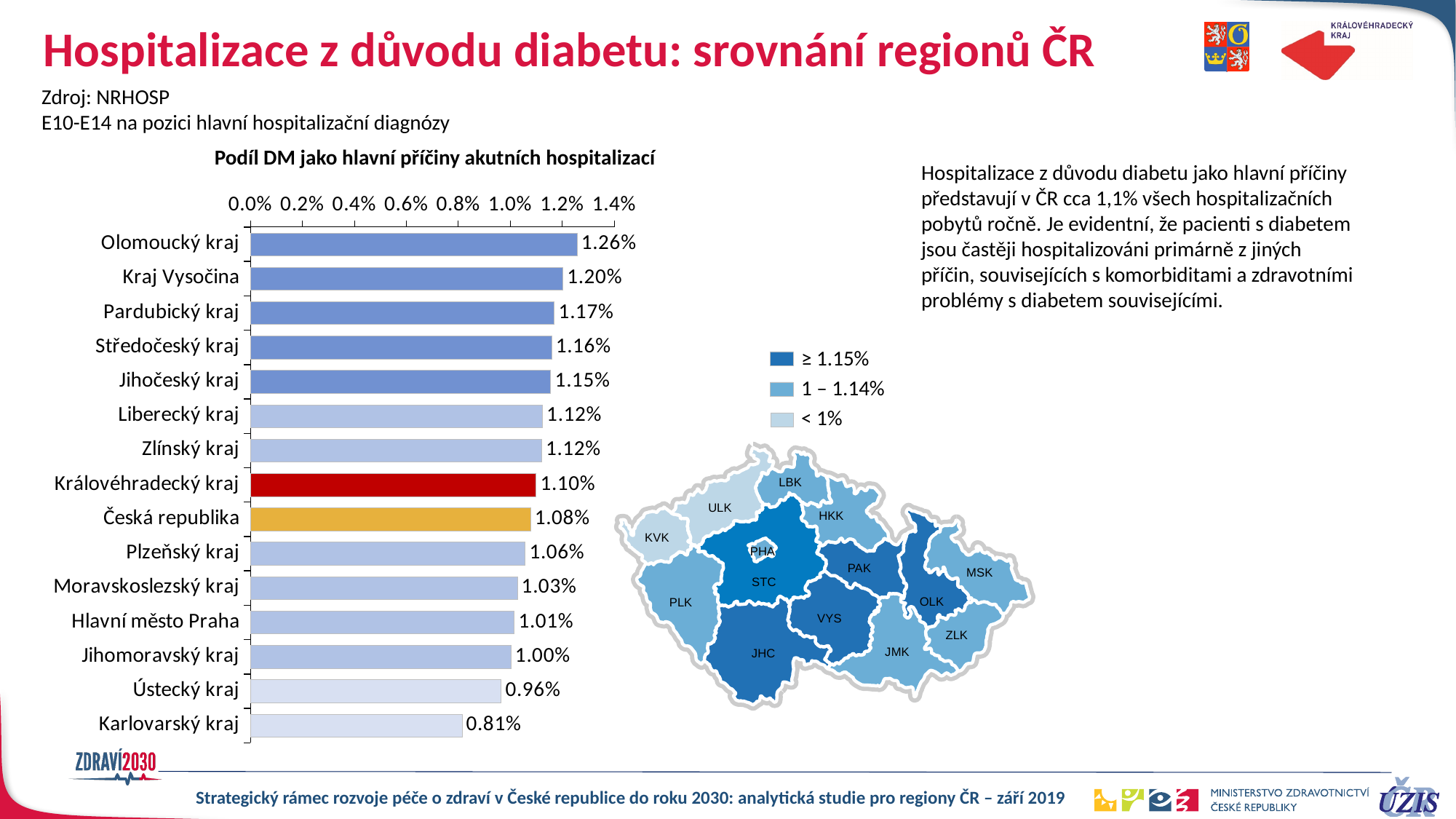
What is the value for Jihomoravský kraj? 1.00% Is the value for Ústecký kraj greater or less than 1.0%? less What kind of chart is used to show the regional values? bar chart What is the value for Olomoucký kraj? 1.26% What is the value for Česká republika? 1.08% What is the title of the bar chart? Podíl DM jako hlavní příčiny akutních hospitalizací How many categories are shown in the bar chart? 15 What is the difference between the values for Olomoucký kraj and Karlovarský kraj? 0.45% What is the value for Královéhradecký kraj? 1.10% Which is larger, the value for Kraj Vysočina or the value for Pardubický kraj? Kraj Vysočina Which category has the lowest value? Karlovarský kraj Which category has the highest value? Olomoucký kraj